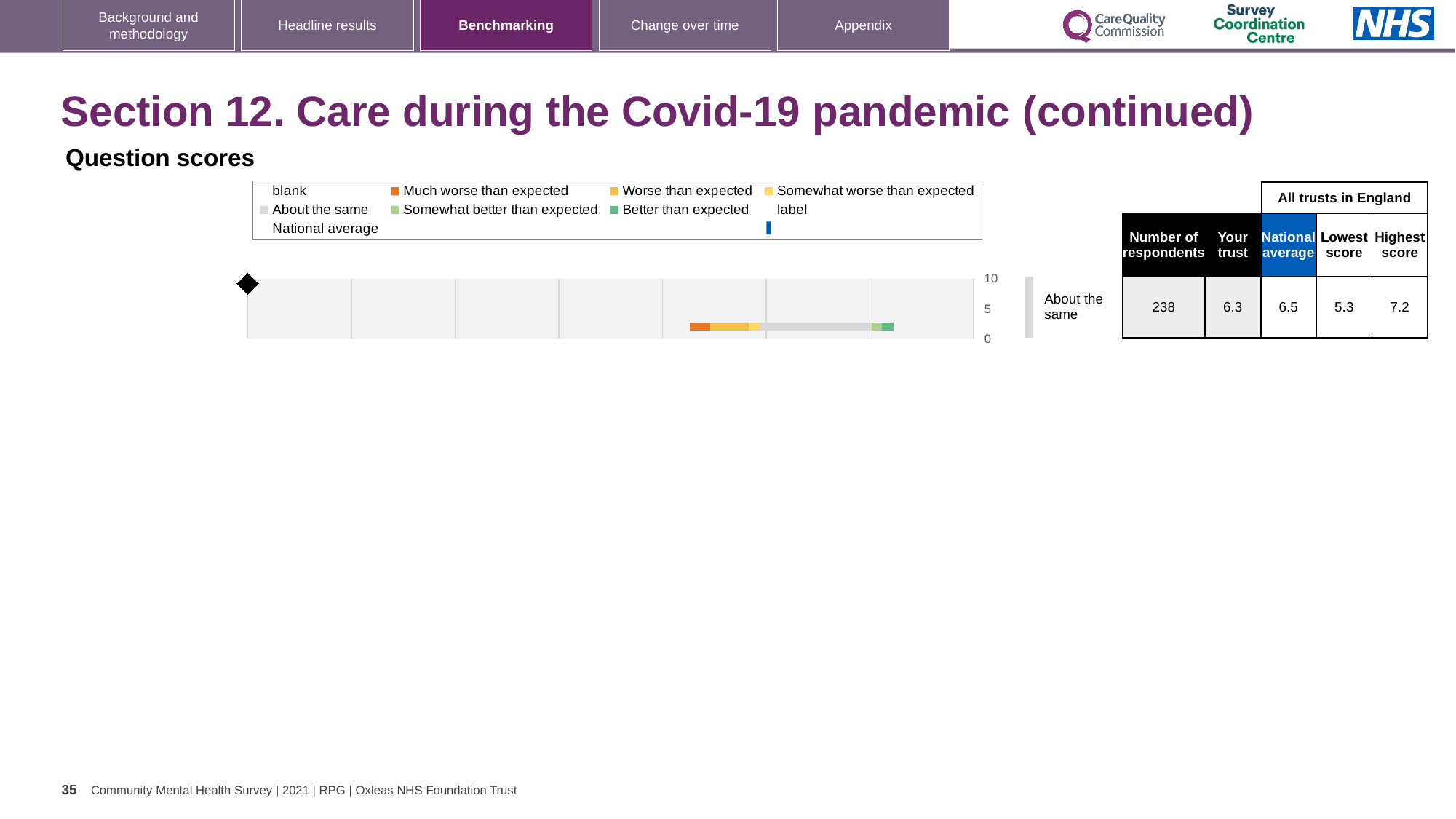
What is the 'Your trust' score shown in the table next to the chart? 6.3 Which is larger, the 'Your trust' score or the National average score? National average What benchmark category label is shown beside the bar? About the same What is the highest value shown on the chart's axis? 10 What is the difference between the Highest score and the Lowest score in the table? 1.9 What is the National average score shown in the table next to the chart? 6.5 Which colour does the legend use for 'Much worse than expected'? orange What kind of chart is shown under 'Question scores'? bar chart What is the Lowest score among all trusts in England shown in the table? 5.3 What is the Highest score among all trusts in England shown in the table? 7.2 How many question bars are plotted in the chart? 1 How many respondents are listed in the table for this question? 238